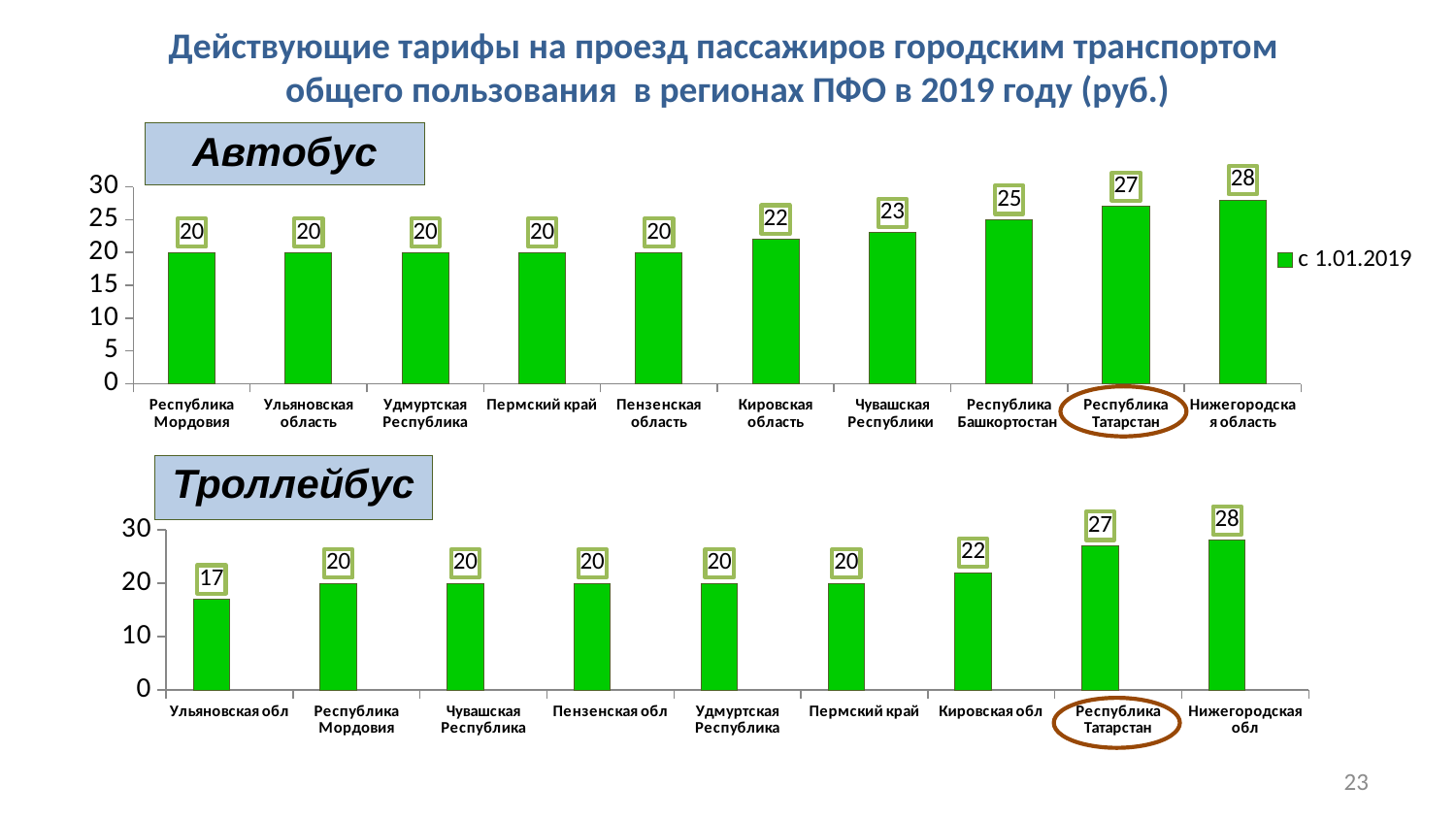
In the Троллейбус chart, which is larger: Кировская обл or Пермский край? Кировская обл In the Троллейбус chart, what is the value for Ульяновская обл? 17 In the Автобус chart, what is the value for Кировская область? 22 In the Троллейбус chart, what is the difference between Нижегородская обл and Ульяновская обл? 11 In the Троллейбус chart, how many regions are shown? 9 In the Автобус chart, which region has the highest value? Нижегородская область What type of chart is the Троллейбус chart? Bar chart In the Автобус chart, what is the legend entry? с 1.01.2019 In the Автобус chart, how many regions are shown? 10 In the Троллейбус chart, which region has the lowest value? Ульяновская обл In the Автобус chart, what is the difference between Нижегородская область and Республика Башкортостан? 3 In the Автобус chart, what is the value for Республика Татарстан? 27